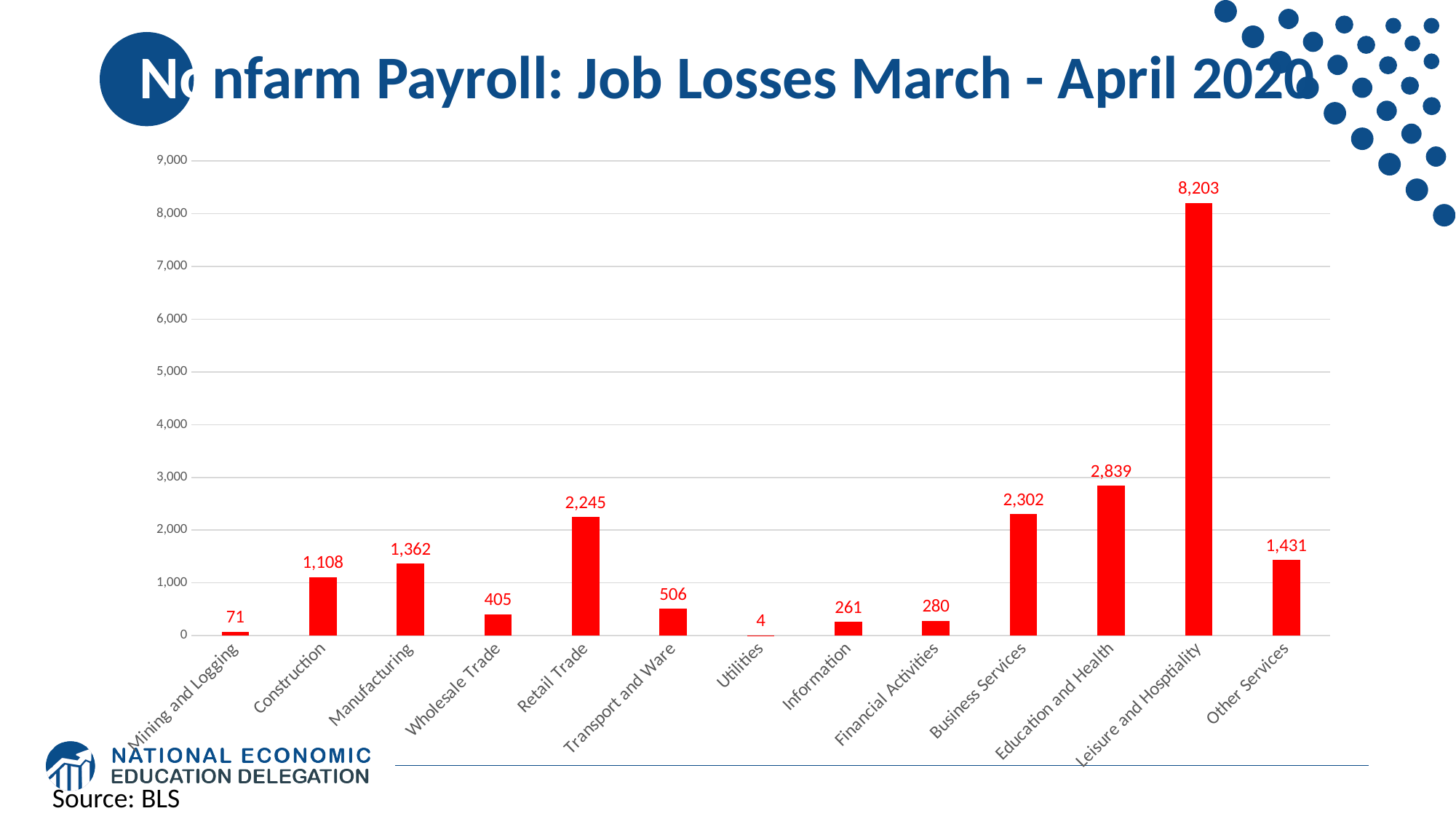
What is the value for Leisure and Hospitiality? 8,203 What is the title of the slide? Nonfarm Payroll: Job Losses March - April 2020 What is the value for Retail Trade? 2,245 What is the difference between the values for Transport and Ware and Wholesale Trade? 101 What is the difference between the values for Education and Health and Business Services? 537 Is the value for Other Services greater or less than 1,000? greater Which is larger, the value for Manufacturing or the value for Construction? Manufacturing Which category has the highest value? Leisure and Hospitiality What kind of chart is shown on the slide? bar chart What is the value for Utilities? 4 How many categories are shown on the x axis? 13 Which category has the lowest value? Utilities